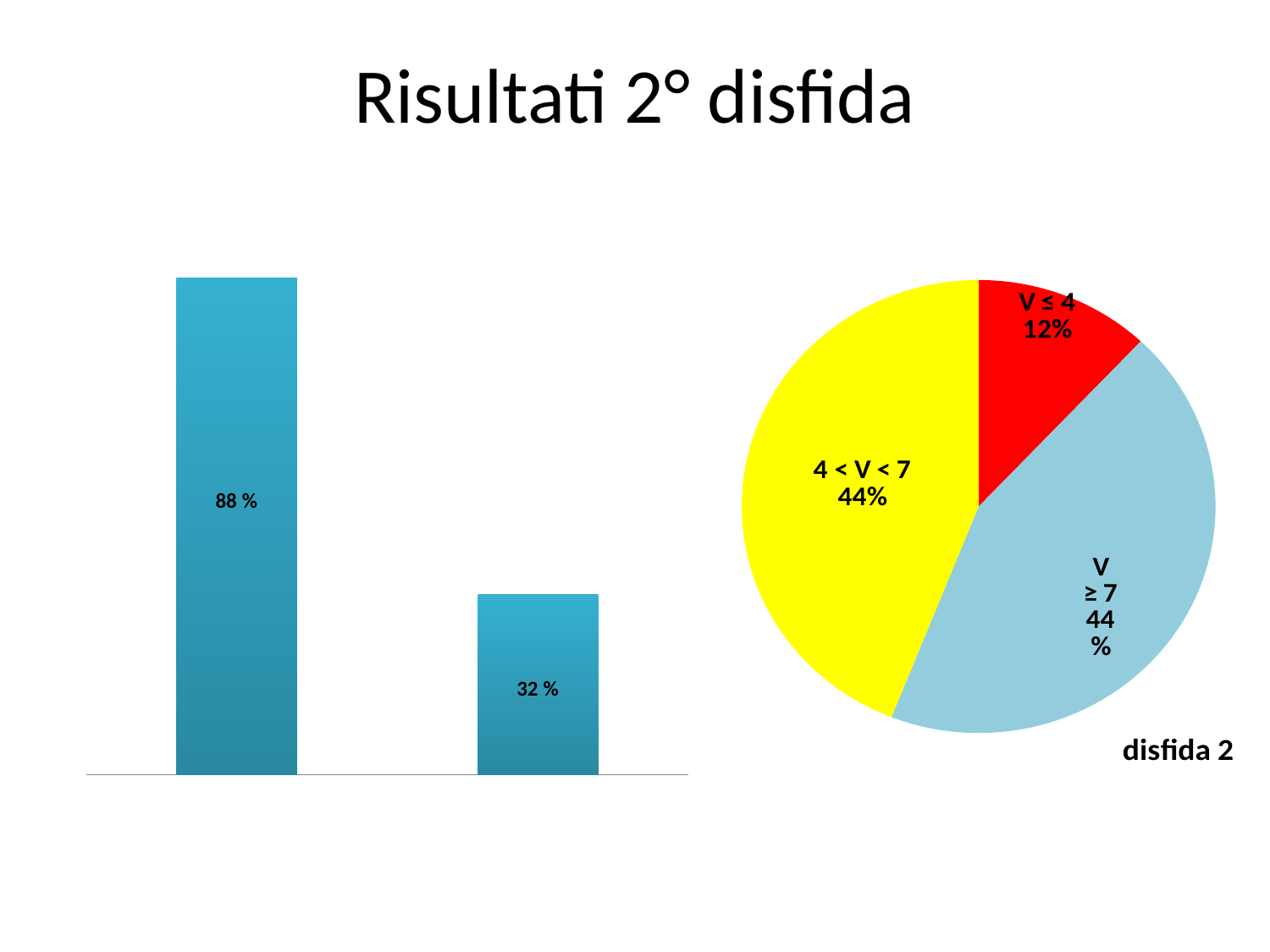
In the bar chart on the left, what value is printed on the left bar? 88 % In the pie chart 'disfida 2', what colour is the slice 'V ≤ 4'? red In the pie chart 'disfida 2', what share does the slice 'V ≥ 7' have? 44% How many slices does the pie chart 'disfida 2' have? 3 In the bar chart on the left, which bar is taller, the left one or the right one? the left one In the pie chart 'disfida 2', which slice is the smallest? V ≤ 4 In the bar chart on the left, what is the difference between the left bar (88 %) and the right bar (32 %)? 56 % How many bars are shown in the bar chart on the left? 2 In the pie chart 'disfida 2', what share does the slice '4 < V < 7' have? 44% In the bar chart on the left, what value is printed on the right bar? 32 % What kind of chart is shown on the left of the slide? bar chart In the pie chart 'disfida 2', what share does the slice 'V ≤ 4' have? 12%